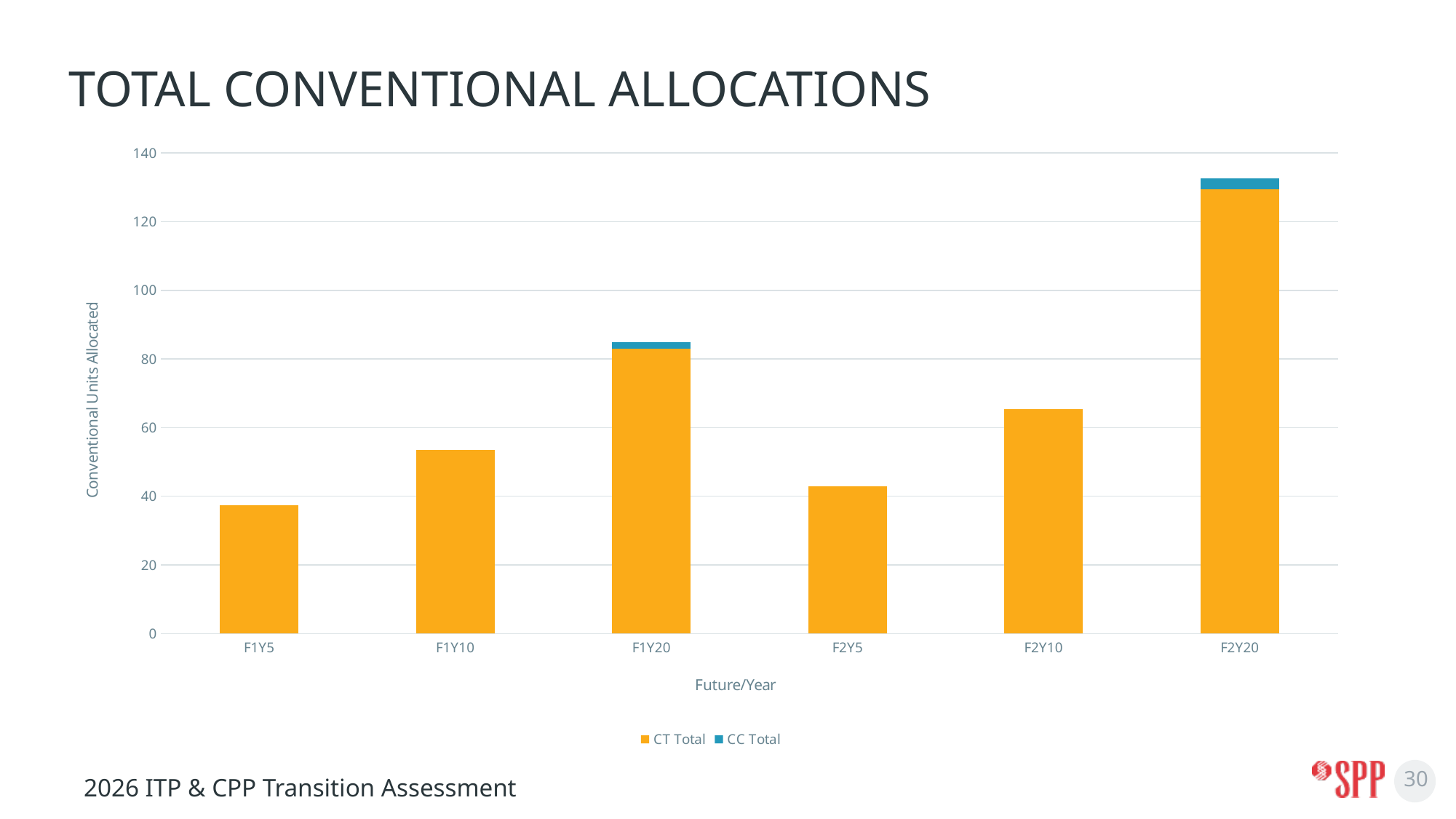
How many categories are shown on the x axis? 6 Is the total value for F2Y20 greater or less than 120? greater What kind of chart is shown on the slide? bar chart Is the total value for F2Y10 greater or less than 60? greater Is the total value for F1Y5 greater or less than 40? less Which category has the lowest total bar? F1Y5 How many series does the legend list? 2 Which series is shown in orange? CT Total What is the title of the y axis? Conventional Units Allocated Which is larger, the total bar for F1Y10 or the total bar for F2Y5? F1Y10 Which category has the highest total bar? F2Y20